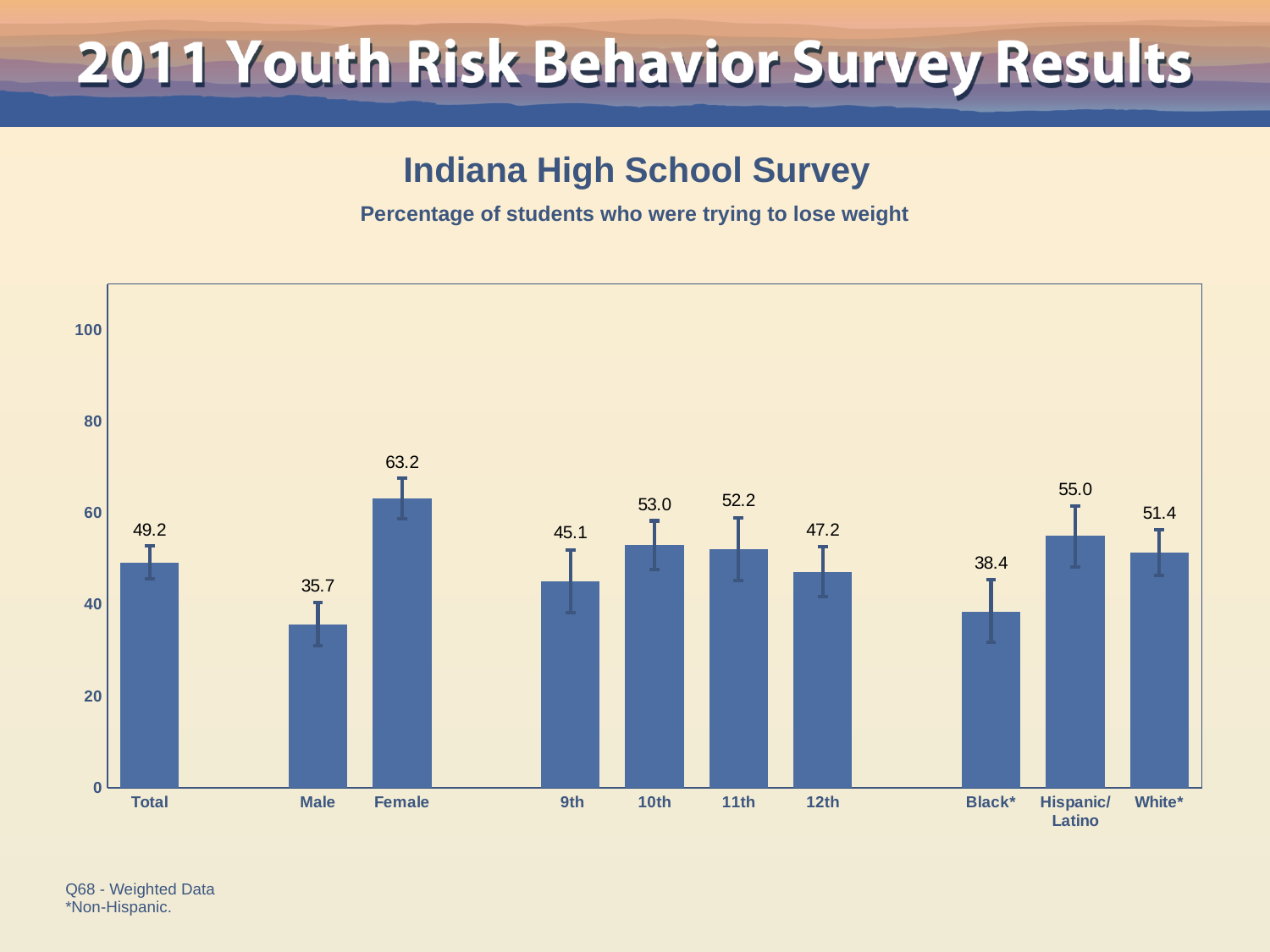
Which category has the lowest value? Male How many categories are shown on the x axis? 10 What is the value for Black*? 38.4 Which is larger, the value for Hispanic/Latino or the value for White*? Hispanic/Latino Which category has the highest value? Female What is the difference between the Female and Male values? 27.5 What is the value for Female? 63.2 What is the value for 10th? 53.0 What is the difference between the Hispanic/Latino and Black* values? 16.6 What is the subtitle of the chart describing what is measured? Percentage of students who were trying to lose weight Is the value for 9th greater or less than 40? greater What kind of chart is this? bar chart